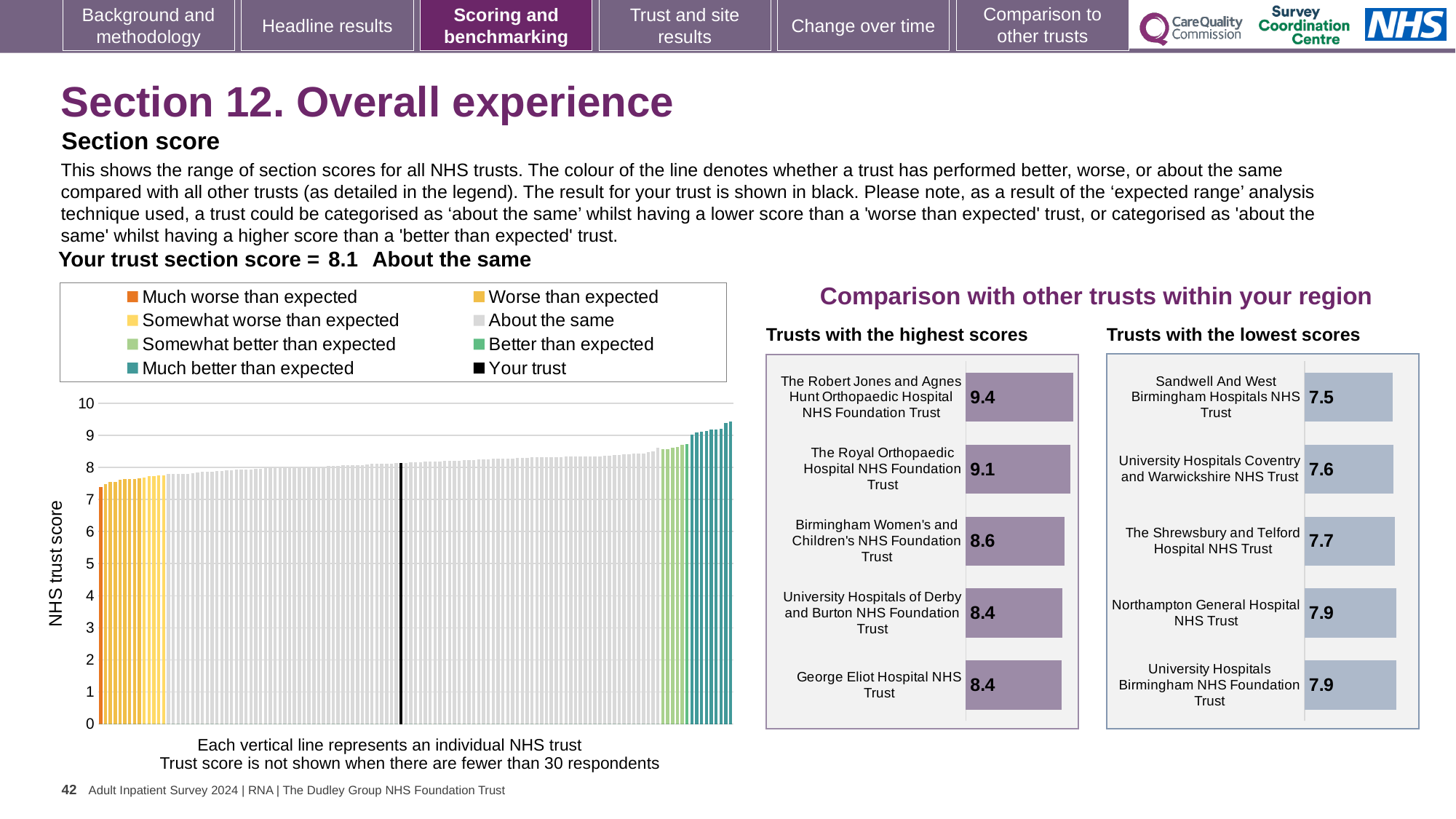
How many entries does the legend of the main 'NHS trust score' bar chart list? 8 In the main 'NHS trust score' chart, what is the section score for your trust, shown by the black bar? 8.1 What kind of chart is the main chart on the left showing NHS trust scores? Bar chart In the 'Trusts with the lowest scores' chart, which trust has the lowest score? Sandwell And West Birmingham Hospitals NHS Trust In the 'Trusts with the highest scores' chart, what is the score for The Robert Jones and Agnes Hunt Orthopaedic Hospital NHS Foundation Trust? 9.4 In the main 'NHS trust score' chart, do the values rise or fall from left to right? Rise In the 'Trusts with the highest scores' chart, which trust has the highest score? The Robert Jones and Agnes Hunt Orthopaedic Hospital NHS Foundation Trust In the 'Trusts with the highest scores' chart, what is the score for Birmingham Women's and Children's NHS Foundation Trust? 8.6 In the 'Trusts with the lowest scores' chart, what is the score for Sandwell And West Birmingham Hospitals NHS Trust? 7.5 In the 'Trusts with the lowest scores' chart, which has the higher score: The Shrewsbury and Telford Hospital NHS Trust or University Hospitals Coventry and Warwickshire NHS Trust? The Shrewsbury and Telford Hospital NHS Trust How many trusts are shown in the 'Trusts with the highest scores' chart? 5 In the 'Trusts with the highest scores' chart, what is the difference between the scores of The Robert Jones and Agnes Hunt Orthopaedic Hospital NHS Foundation Trust and The Royal Orthopaedic Hospital NHS Foundation Trust? 0.3